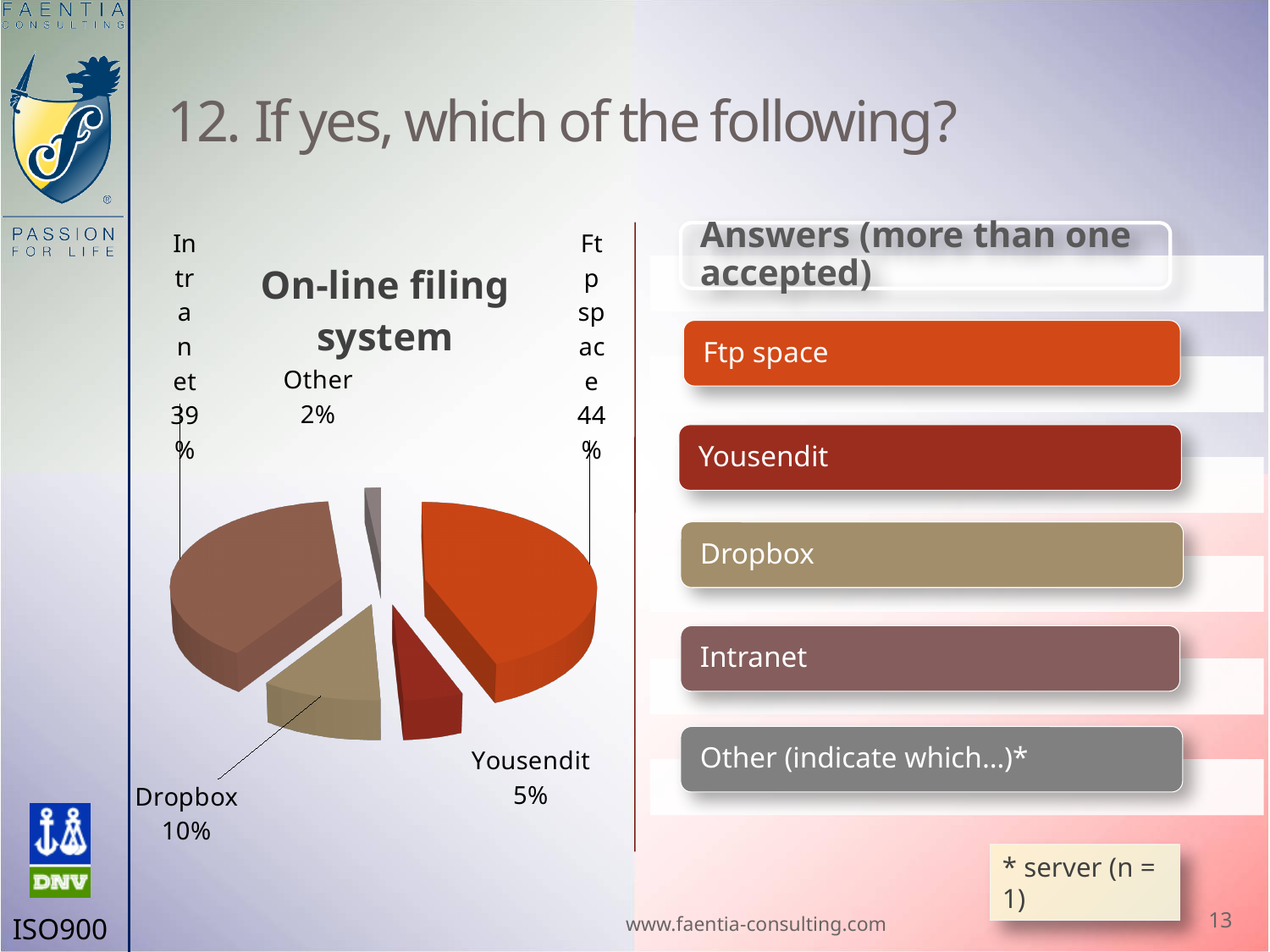
What is the value shown for Dropbox? 10% How many slices does the pie chart have? 5 Which is larger, the share for Dropbox or the share for Yousendit? Dropbox Which category has the largest slice of the pie? Ftp space What percentage of the pie does Ftp space account for? 44% What kind of chart is shown on the slide? pie chart What is the difference in percentage points between Ftp space and Intranet? 5 What is the value shown for Yousendit? 5% What is the title of the chart? On-line filing system What is the value shown for Other? 2% Which category has the smallest slice of the pie? Other What percentage of the pie does Intranet account for? 39%